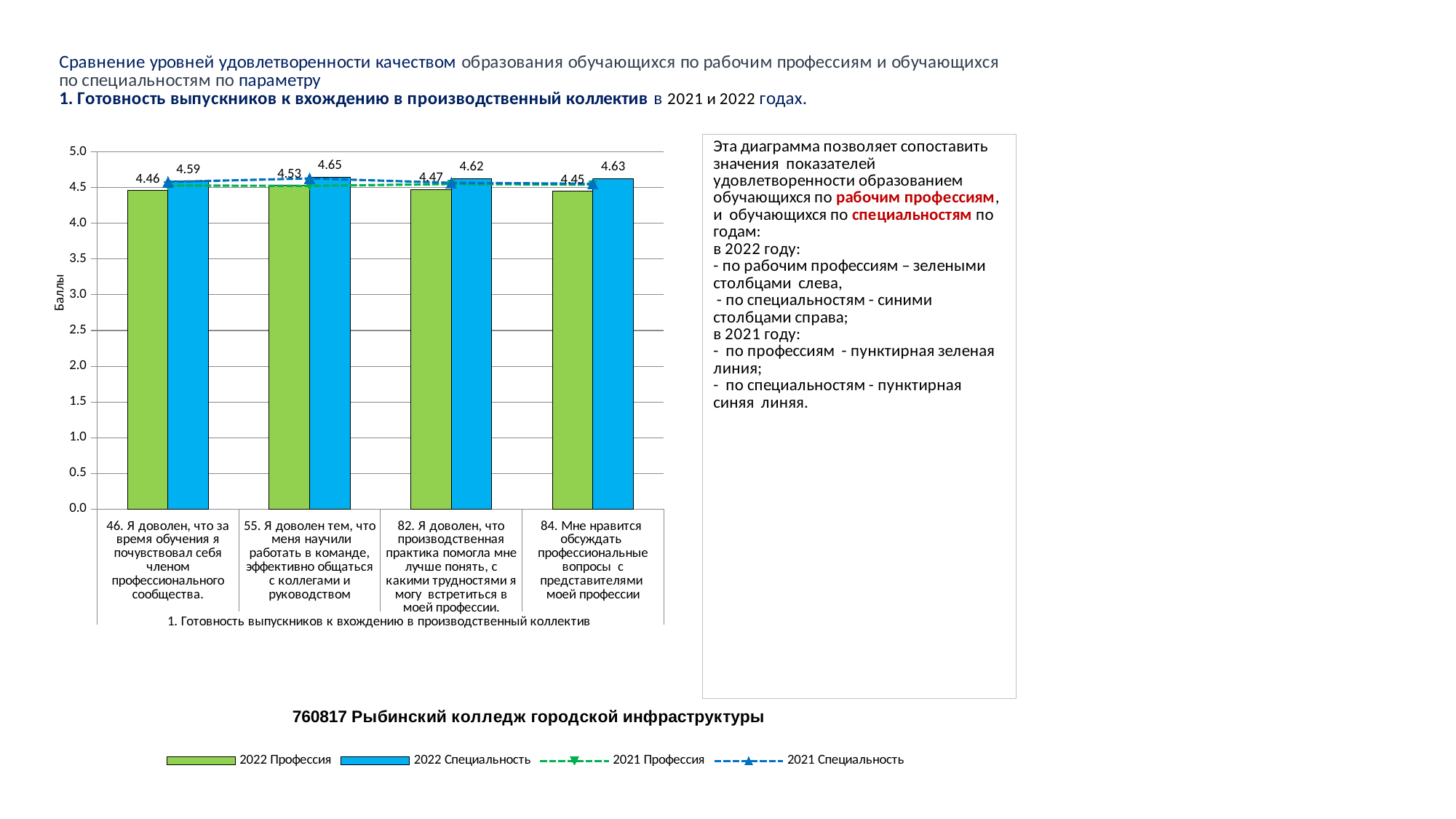
Is the 2021 Специальность value for category 46 greater or less than 4.0? greater What is the 2022 Специальность value for category 55 (Я доволен тем, что меня научили работать в команде)? 4.65 How many categories are shown on the x axis of the chart? 4 What is the difference between the 2022 Специальность and 2022 Профессия values for category 46? 0.13 For category 84, which is larger: the 2022 Профессия value or the 2022 Специальность value? 2022 Специальность What is the 2022 Профессия value for category 46 (Я доволен, что за время обучения я почувствовал себя членом профессионального сообщества)? 4.46 What is the difference between the 2022 Специальность and 2022 Профессия values for category 82? 0.15 What is the label of the vertical axis of the chart? Баллы How many series does the chart legend list? 4 Which category has the highest 2022 Специальность value? 55. Я доволен тем, что меня научили работать в команде, эффективно общаться с коллегами и руководством Which category has the lowest 2022 Профессия value? 84. Мне нравится обсуждать профессиональные вопросы с представителями моей профессии What is the 2022 Специальность value for category 84 (Мне нравится обсуждать профессиональные вопросы с представителями моей профессии)? 4.63